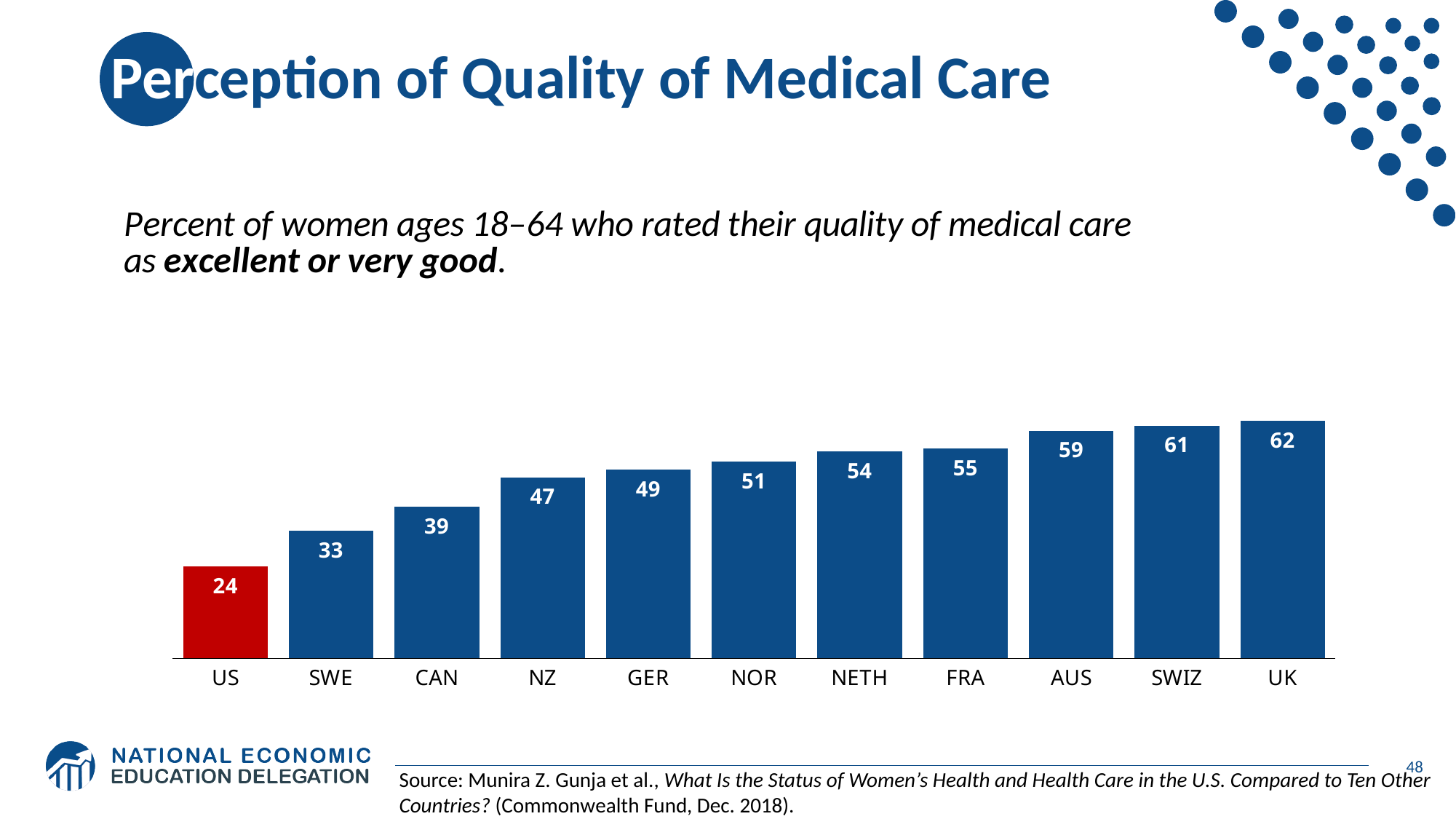
What is the value for GER? 49 What is the value for the US? 24 Which country has the lowest value? US How many countries are shown in the chart? 11 Which has a larger value, SWE or NZ? NZ Which bar is coloured red rather than blue? US What is the value for AUS? 59 What kind of chart is shown on the slide? Bar chart What is the difference between the values for NETH and CAN? 15 Which country has the highest value? UK Do the values rise or fall from left to right along the x axis? Rise What is the difference between the values for UK and US? 38